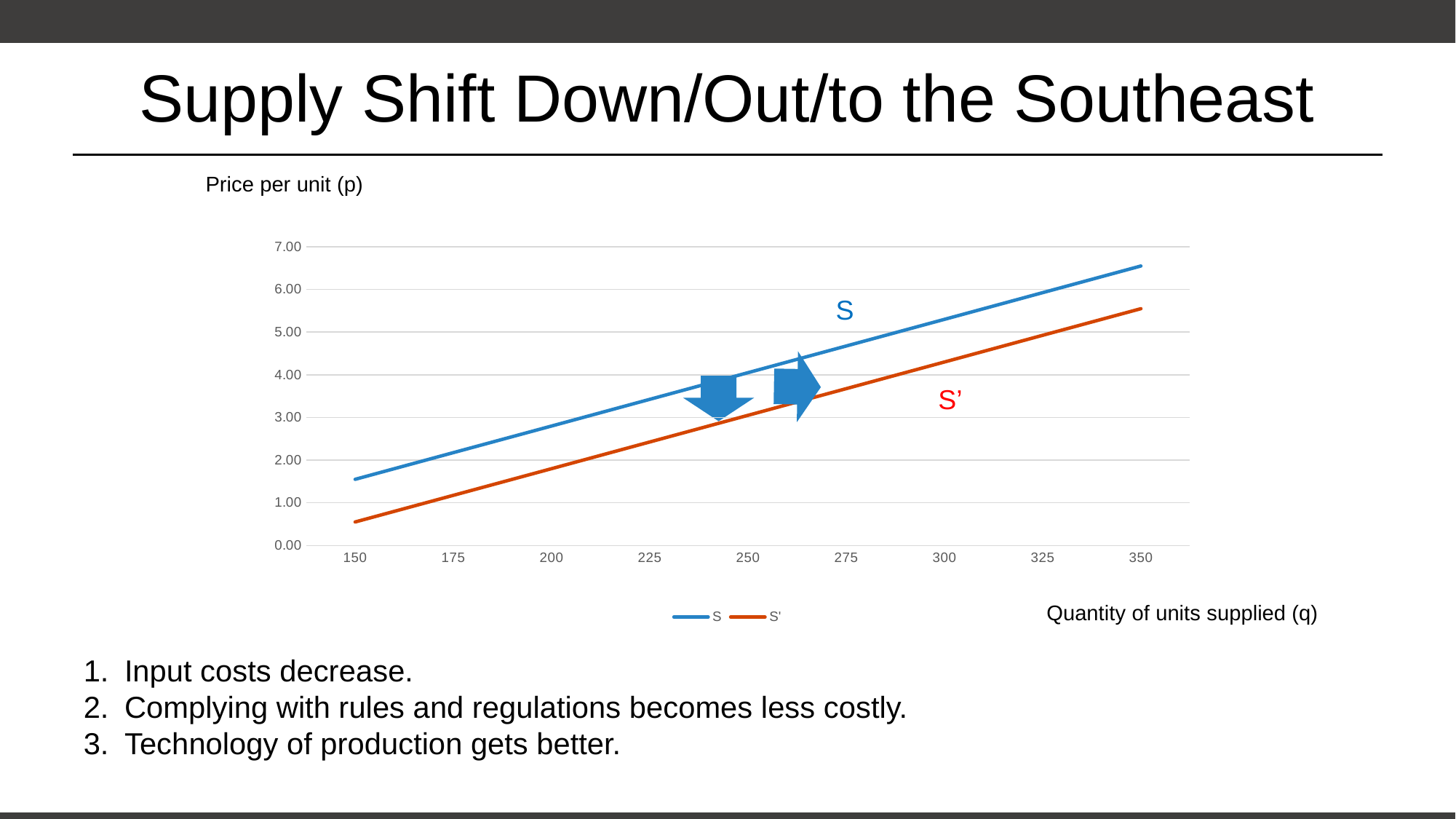
Is the value of the S' line at a quantity of 350 greater or less than 5.00? greater How many series does the legend list? 2 At a quantity of 150, which line has the lower price, S or S'? S' Is the value of the S' line at a quantity of 150 greater or less than 1.00? less What colour is the S' line? red Do the values of the S line rise or fall as quantity increases along the x axis? rise Is the value of the S line at a quantity of 150 greater or less than 2.00? less What kind of chart is shown on the slide? line chart At a quantity of 350, which line has the higher price, S or S'? S What are the names of the two series in the legend? S and S' Do the values of the S' line rise or fall as quantity increases along the x axis? rise